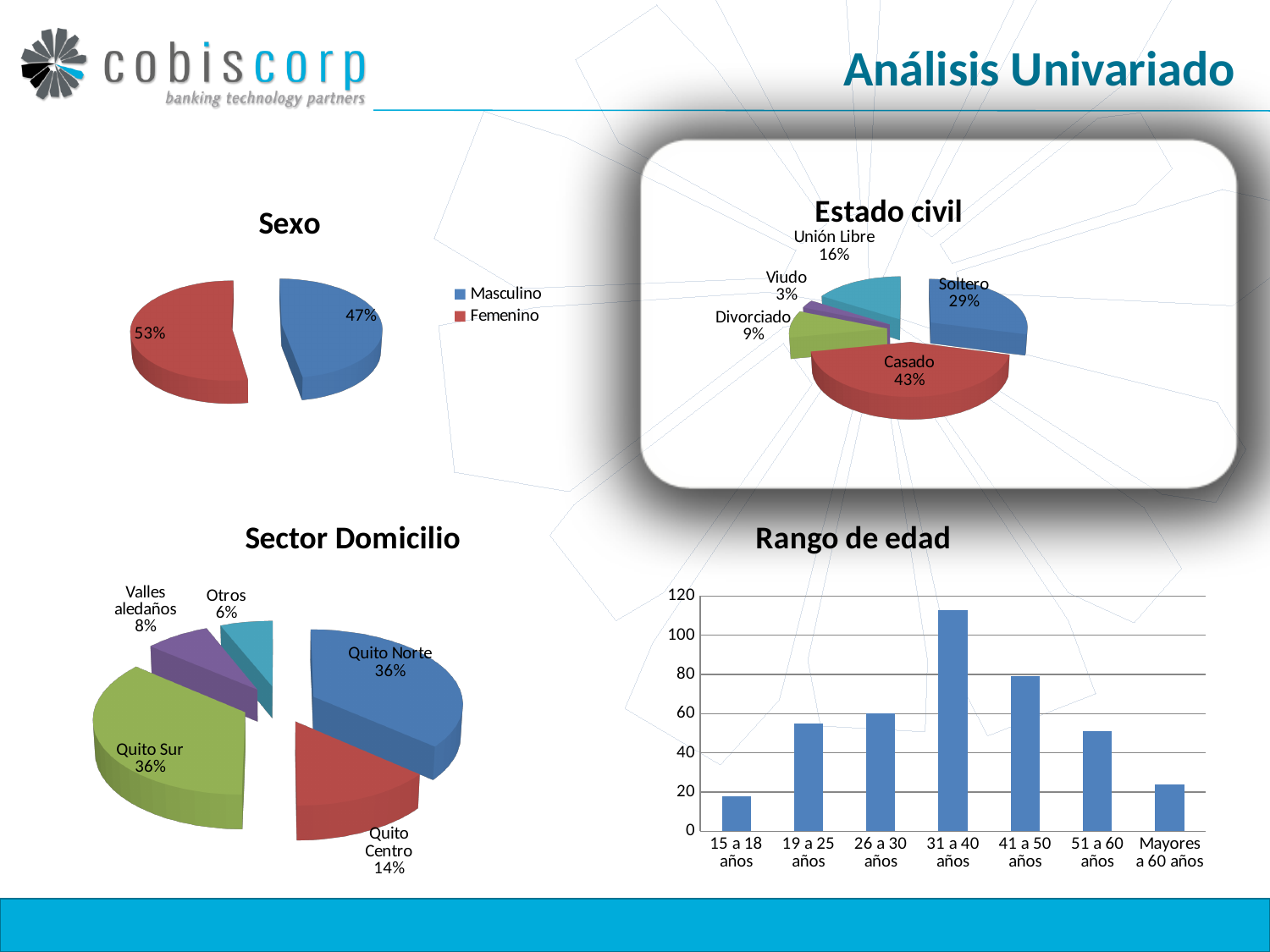
In the Estado civil chart, which category has the smallest share? Viudo What kind of chart is the Rango de edad chart? bar chart In the Estado civil chart, how many categories are shown? 5 In the Rango de edad chart, is the value for 31 a 40 años greater or less than 100? greater In the Estado civil chart, what percentage is Casado? 43% In the Sector Domicilio chart, which is larger, Valles aledaños or Otros? Valles aledaños In the Estado civil chart, what is the difference between the Soltero and Unión Libre shares? 13% In the Sexo chart, what percentage is Masculino? 47% In the Rango de edad chart, which age range has the highest value? 31 a 40 años In the Sexo chart, what percentage is Femenino? 53% In the Rango de edad chart, how many age ranges are shown on the x axis? 7 In the Sector Domicilio chart, what percentage is Quito Centro? 14%